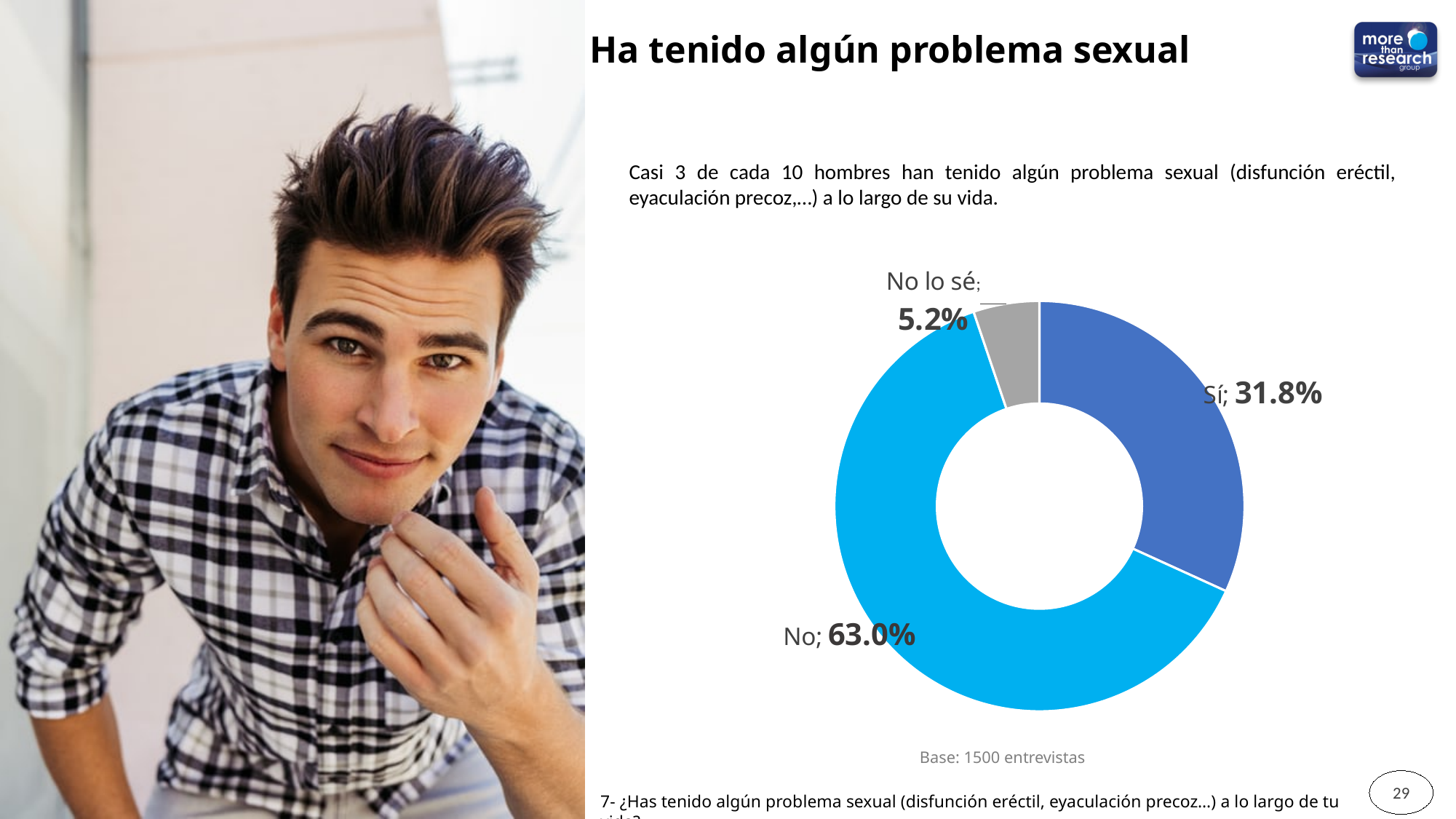
How many categories are shown in the chart? 3 What is the difference in percentage points between "No" and "Sí"? 31.2 What is the difference in percentage points between "Sí" and "No lo sé"? 26.6 What is the base (number of interviews) stated below the chart? 1500 entrevistas What percentage of respondents answered "No"? 63.0% What is the title of the slide containing the chart? Ha tenido algún problema sexual What percentage of respondents answered "No lo sé"? 5.2% Which category has the smallest share of the chart? No lo sé Which category has the largest share of the chart? No Which is larger, the share for "Sí" or the share for "No lo sé"? Sí What kind of chart is shown on the slide? Pie chart (doughnut) What percentage of respondents answered "Sí"? 31.8%